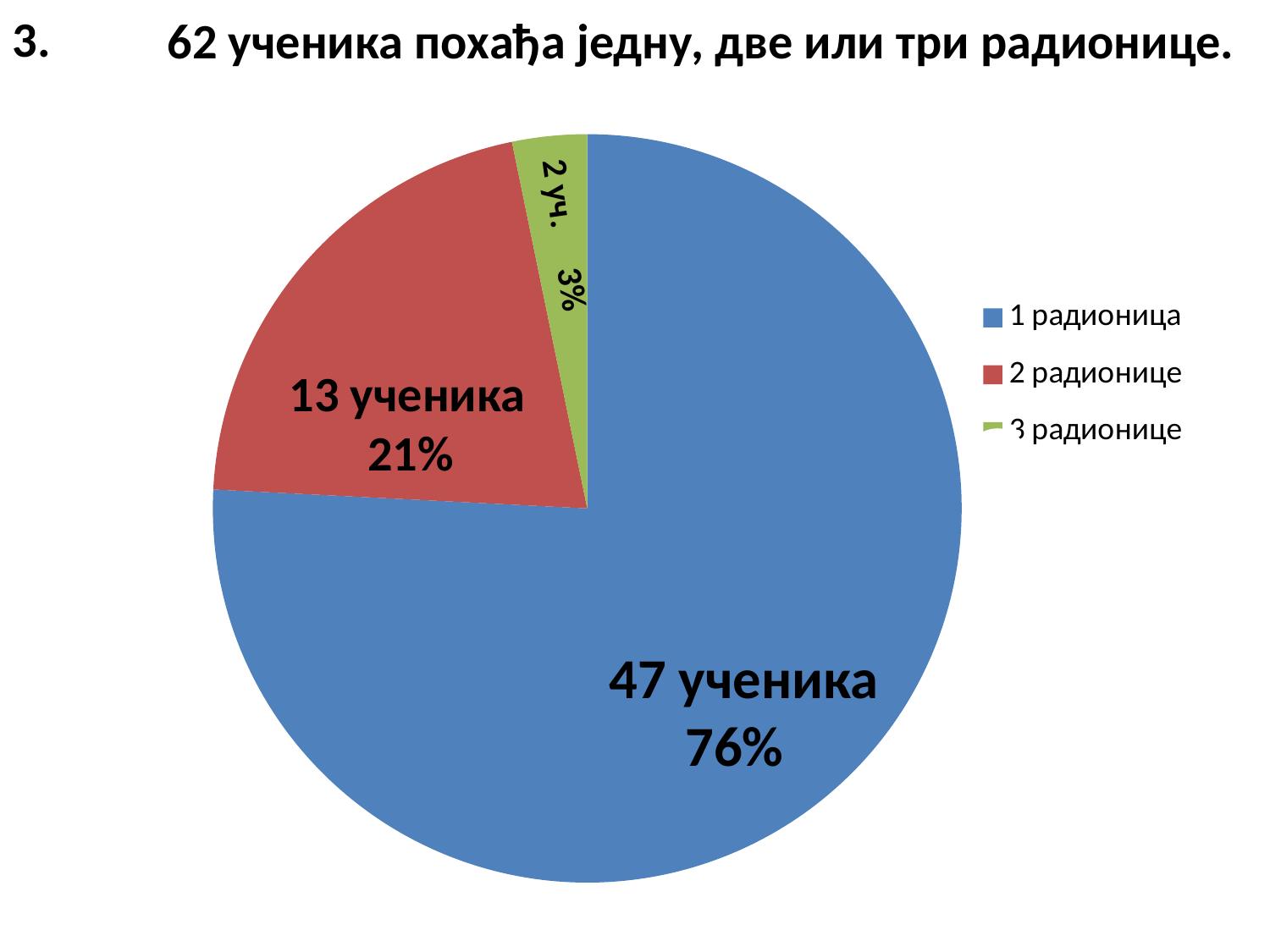
How many students attend 2 радионице? 13 ученика Which category has the smallest slice of the pie? 3 радионице What kind of chart is shown on the slide? pie chart What share of the pie does the 2 радионице slice represent? 21% What share of the pie does the 3 радионице slice represent? 3% How many more students attend 1 радионица than 2 радионице? 34 What share of the pie does the 1 радионица slice represent? 76% How many slices does the pie chart have? 3 How many students attend 1 радионица? 47 ученика Which category has the largest slice of the pie? 1 радионица What colour is the slice for 2 радионице? red How many students attend 3 радионице? 2 уч.